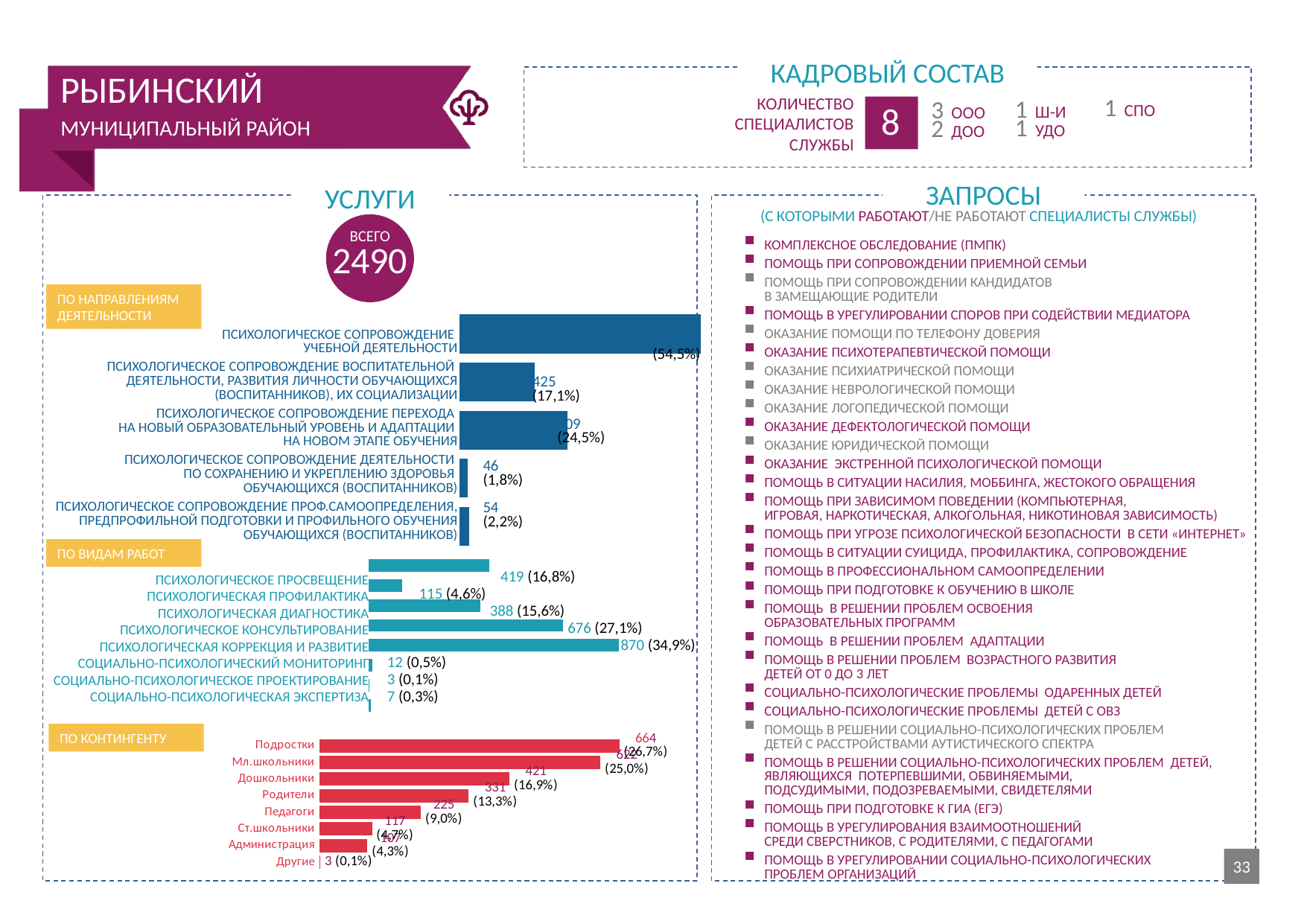
In the 'ПО ВИДАМ РАБОТ' chart, what is the value for ПСИХОЛОГИЧЕСКАЯ КОРРЕКЦИЯ И РАЗВИТИЕ? 870 In the 'ПО ВИДАМ РАБОТ' chart, what percentage is shown for ПСИХОЛОГИЧЕСКОЕ КОНСУЛЬТИРОВАНИЕ? 27,1% In the 'ПО КОНТИНГЕНТУ' chart, which is larger: Дошкольники or Педагоги? Дошкольники In the 'ПО ВИДАМ РАБОТ' chart, which category has the highest value? ПСИХОЛОГИЧЕСКАЯ КОРРЕКЦИЯ И РАЗВИТИЕ How many categories are shown in the 'ПО ВИДАМ РАБОТ' chart? 8 In the 'ПО ВИДАМ РАБОТ' chart, which category has the lowest value? СОЦИАЛЬНО-ПСИХОЛОГИЧЕСКОЕ ПРОЕКТИРОВАНИЕ What type of chart is used in the 'ПО КОНТИНГЕНТУ' section? Bar chart In the 'ПО ВИДАМ РАБОТ' chart, what is the difference between ПСИХОЛОГИЧЕСКОЕ ПРОСВЕЩЕНИЕ and ПСИХОЛОГИЧЕСКАЯ ДИАГНОСТИКА? 31 In the 'ПО КОНТИНГЕНТУ' chart, what is the value for Подростки? 664 In the 'ПО КОНТИНГЕНТУ' chart, what percentage is shown for Родители? 13,3% In the 'ПО НАПРАВЛЕНИЯМ ДЕЯТЕЛЬНОСТИ' chart, what is the value for ПСИХОЛОГИЧЕСКОЕ СОПРОВОЖДЕНИЕ ПРОФ.САМООПРЕДЕЛЕНИЯ, ПРЕДПРОФИЛЬНОЙ ПОДГОТОВКИ И ПРОФИЛЬНОГО ОБУЧЕНИЯ ОБУЧАЮЩИХСЯ (ВОСПИТАННИКОВ)? 54 In the 'ПО КОНТИНГЕНТУ' chart, what is the difference between Дошкольники and Ст.школьники? 304